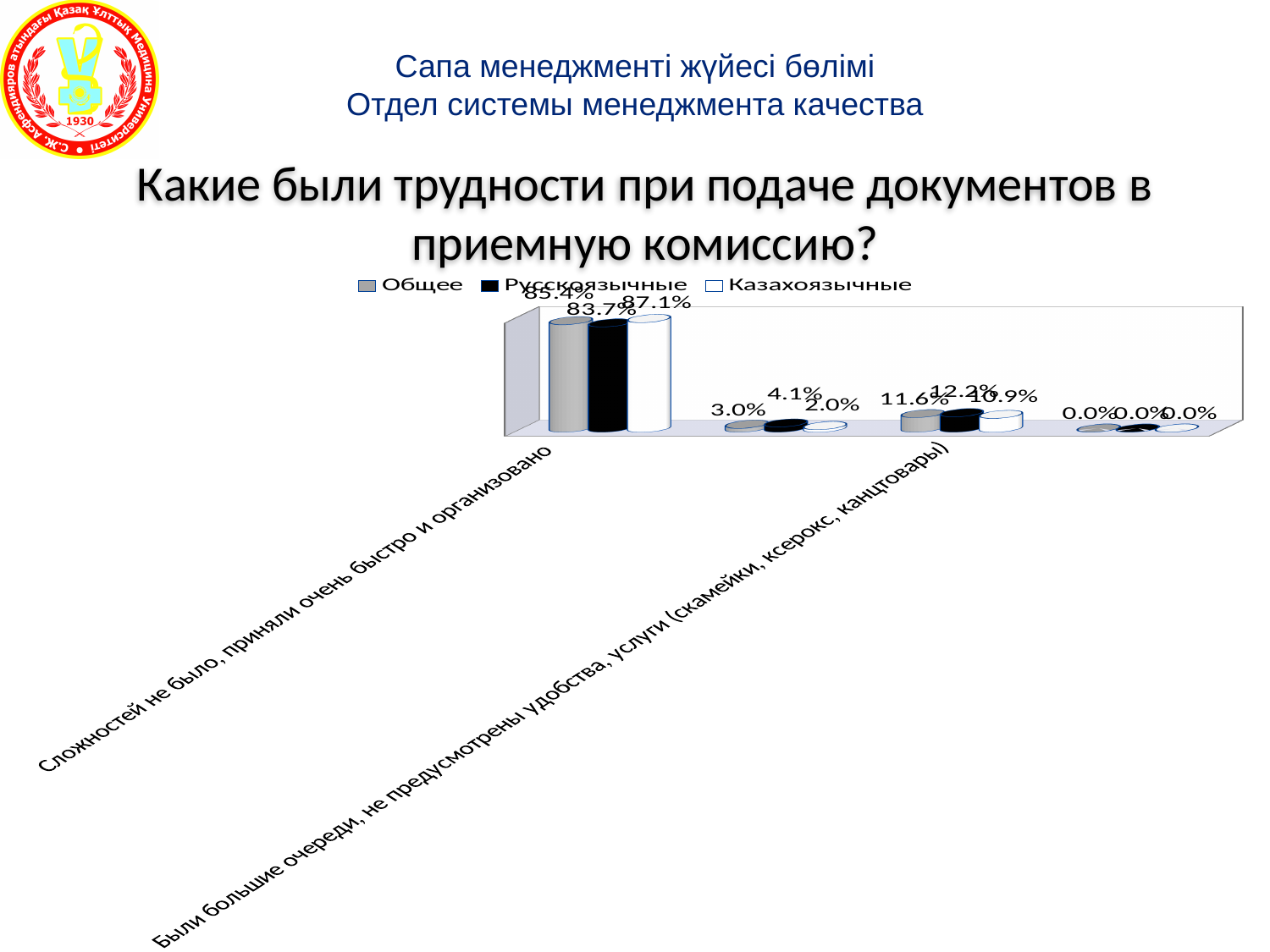
What is the value for Русскоязычные in the category 'Были большие очереди, не предусмотрены удобства, услуги (скамейки, ксерокс, канцтовары)'? 12.2% In the category 'Сложностей не было, приняли очень быстро и организовано', which is larger: the value for Русскоязычные or for Казахоязычные? Казахоязычные What kind of chart is shown on the slide? Bar chart What is the value for Русскоязычные in the category 'Сложностей не было, приняли очень быстро и организовано'? 83.7% How many category groups of bars are plotted in the chart? 4 Which category has the highest value for the Общее series? Сложностей не было, приняли очень быстро и организовано What is the value for Казахоязычные in the category 'Сложностей не было, приняли очень быстро и организовано'? 87.1% What is the value for Общее in the category 'Были большие очереди, не предусмотрены удобства, услуги (скамейки, ксерокс, канцтовары)'? 11.6% Which series are listed in the chart legend? Общее, Русскоязычные, Казахоязычные What is the difference between the Казахоязычные and Русскоязычные values in the category 'Сложностей не было, приняли очень быстро и организовано'? 3.4% What is the value for Общее in the category 'Сложностей не было, приняли очень быстро и организовано'? 85.4% How many series does the chart legend list? 3